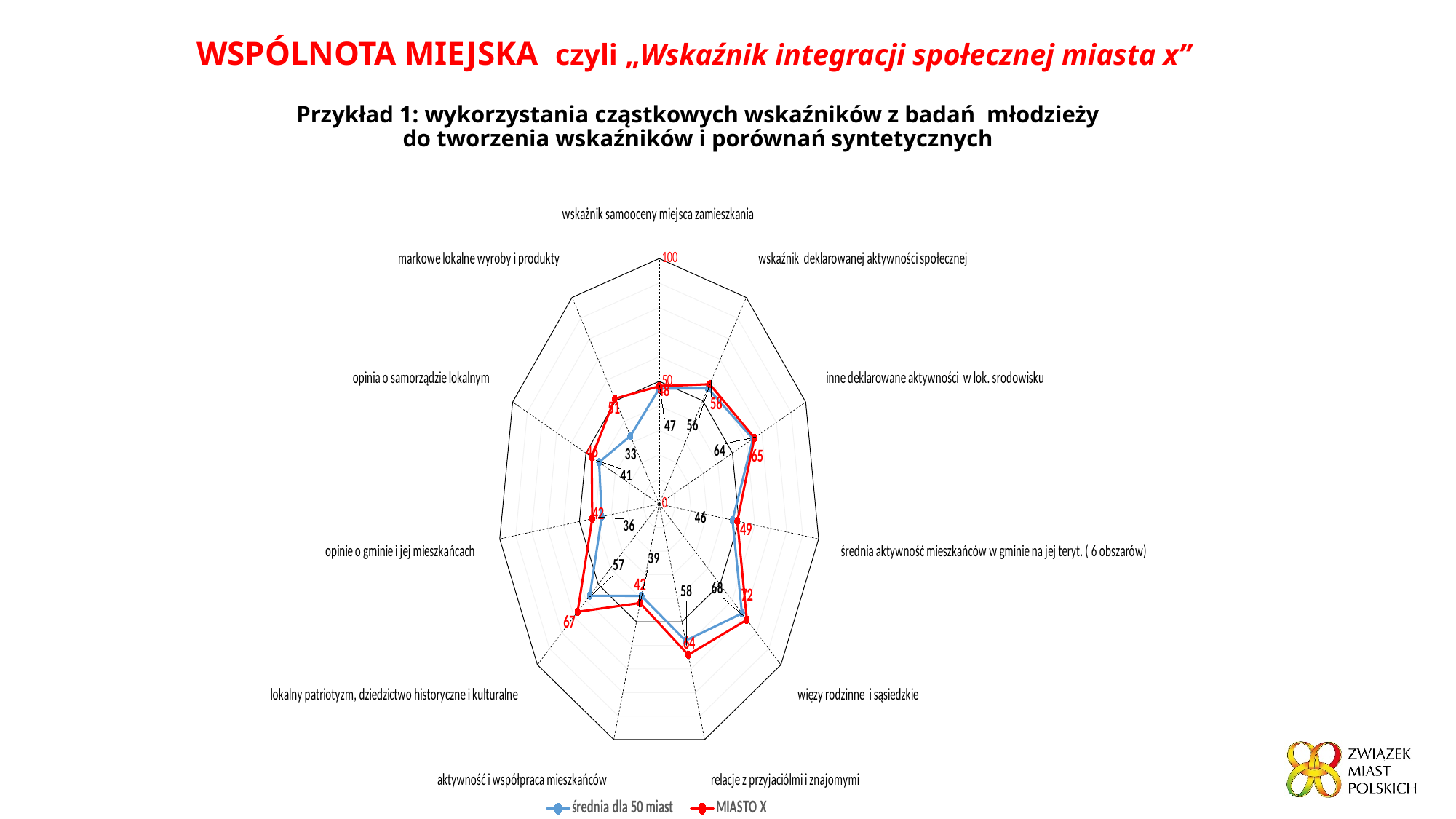
On the axis 'wskaźnik samooceny miejsca zamieszkania', which series has the larger value? MIASTO X What is the lowest value plotted for MIASTO X? 42 What are the two series named in the legend? średnia dla 50 miast and MIASTO X How many series does the legend list? 2 What is the value for 'średnia dla 50 miast' on the axis 'wskaźnik samooceny miejsca zamieszkania'? 47 What is the value for MIASTO X on the axis 'wskaźnik samooceny miejsca zamieszkania'? 48 What is the difference between MIASTO X and 'średnia dla 50 miast' on the axis 'wskaźnik samooceny miejsca zamieszkania'? 1 What colour is the line for MIASTO X? red What is the value for MIASTO X on the axis 'więzy rodzinne i sąsiedzkie'? 72 What kind of chart is shown on the slide? radar chart What is the value for MIASTO X on the axis 'lokalny patriotyzm, dziedzictwo historyczne i kulturalne'? 67 What is the highest value plotted for MIASTO X? 72